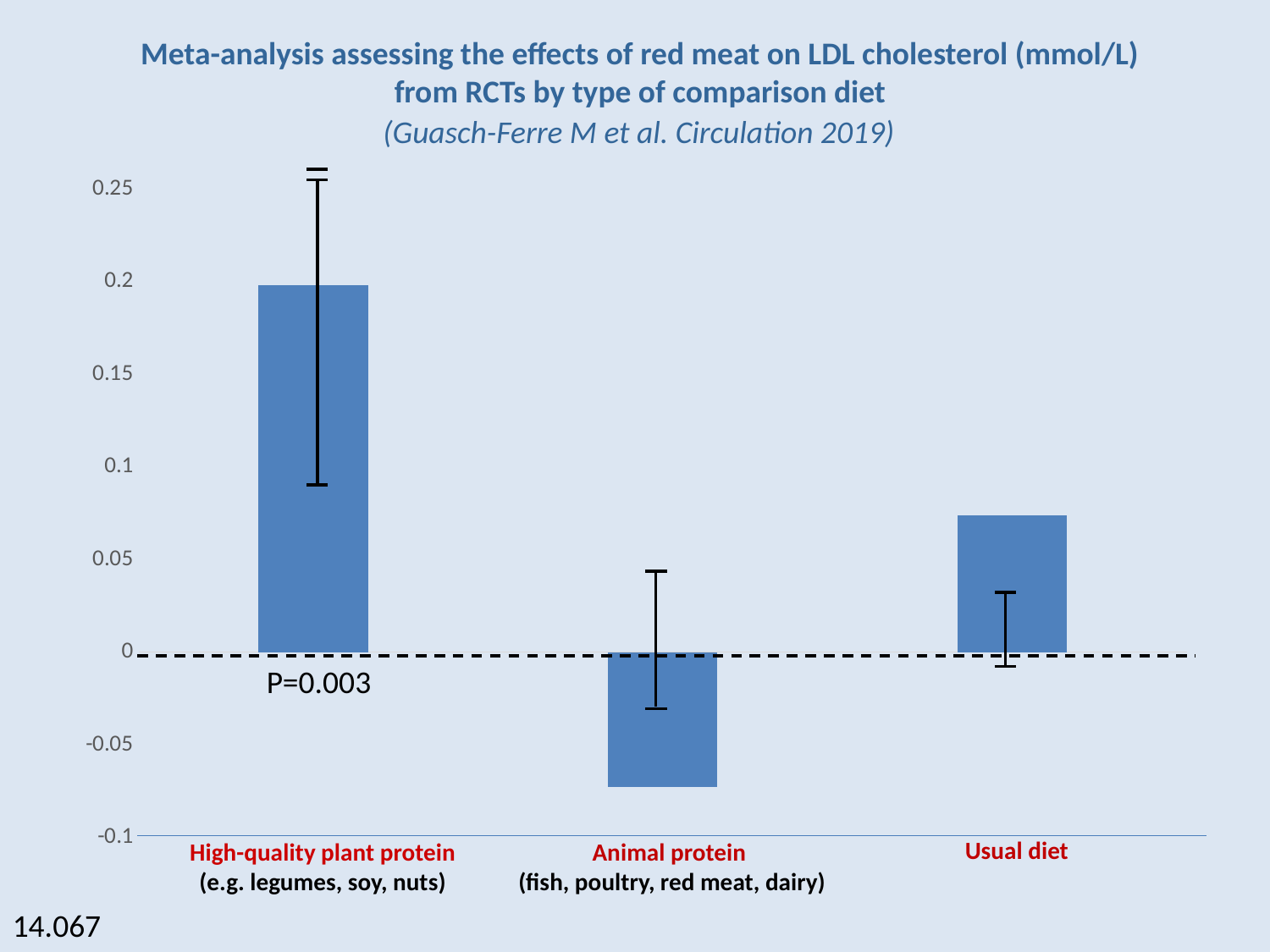
Is the value for High-quality plant protein greater or less than 0.15? greater Is the value for Usual diet greater or less than 0.1? less Which study is cited in the chart title? Guasch-Ferre M et al. Circulation 2019 Is the value for Animal protein greater or less than 0? less Which comparison diet has the lowest LDL cholesterol effect on the chart? Animal protein What P value is printed below the High-quality plant protein bar? P=0.003 Which comparison diet has the highest LDL cholesterol effect on the chart? High-quality plant protein How many comparison diet categories are plotted on the chart? 3 What kind of chart is shown on the slide? bar chart Which is larger, the value for High-quality plant protein or the value for Usual diet? High-quality plant protein